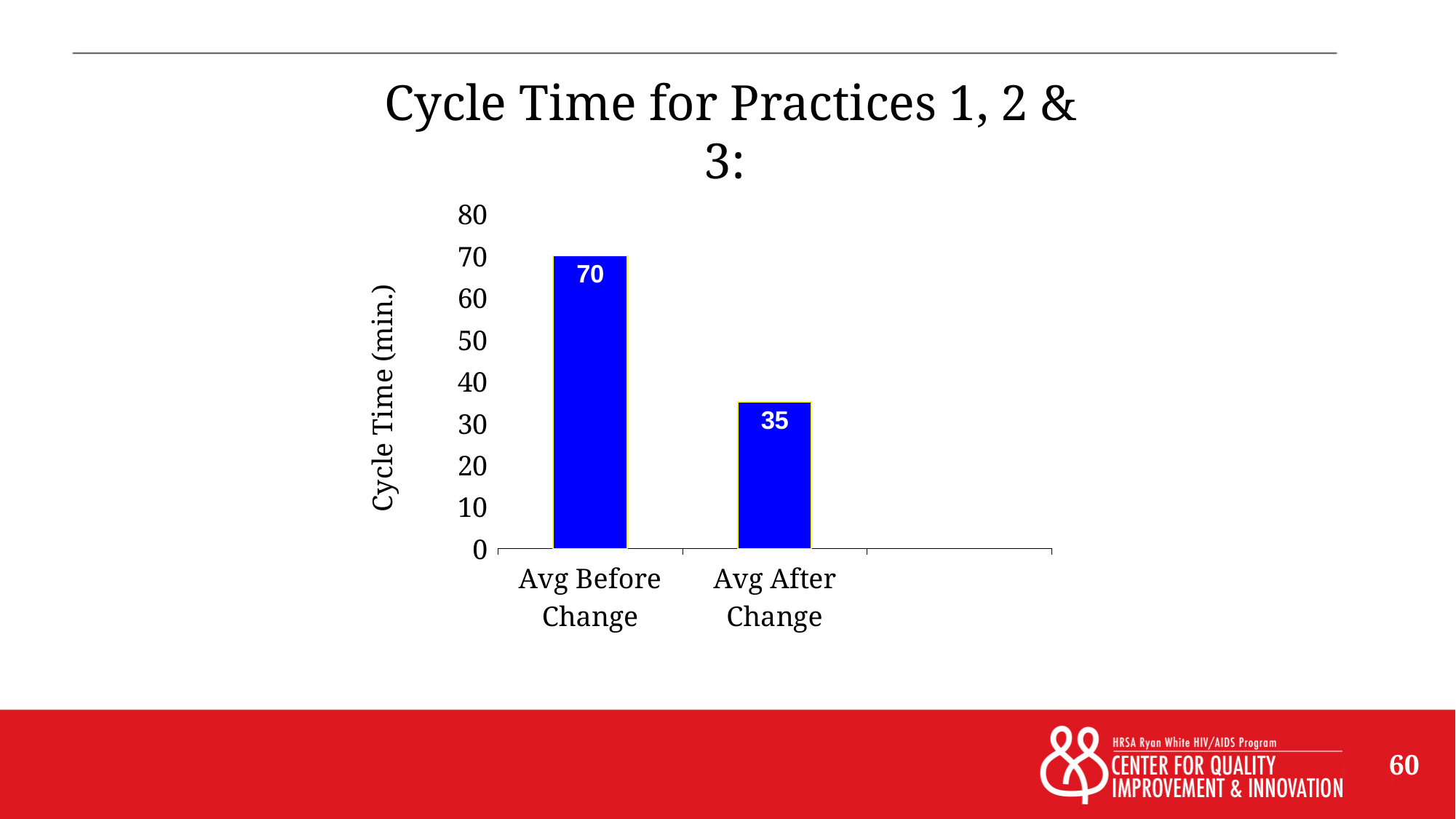
Which category has the lowest cycle time? Avg After Change What is the value for Avg Before Change? 70 Is the value for Avg After Change greater or less than 40? less What kind of chart is shown on the slide? Bar chart What is the value for Avg After Change? 35 Which is larger, the value for Avg Before Change or Avg After Change? Avg Before Change What is the label of the vertical axis? Cycle Time (min.) Is the value for Avg Before Change greater or less than 60? greater How many categories are shown on the x axis? 2 Do the values rise or fall from Avg Before Change to Avg After Change? Fall What is the difference between the Avg Before Change and Avg After Change values? 35 Which category has the highest cycle time? Avg Before Change